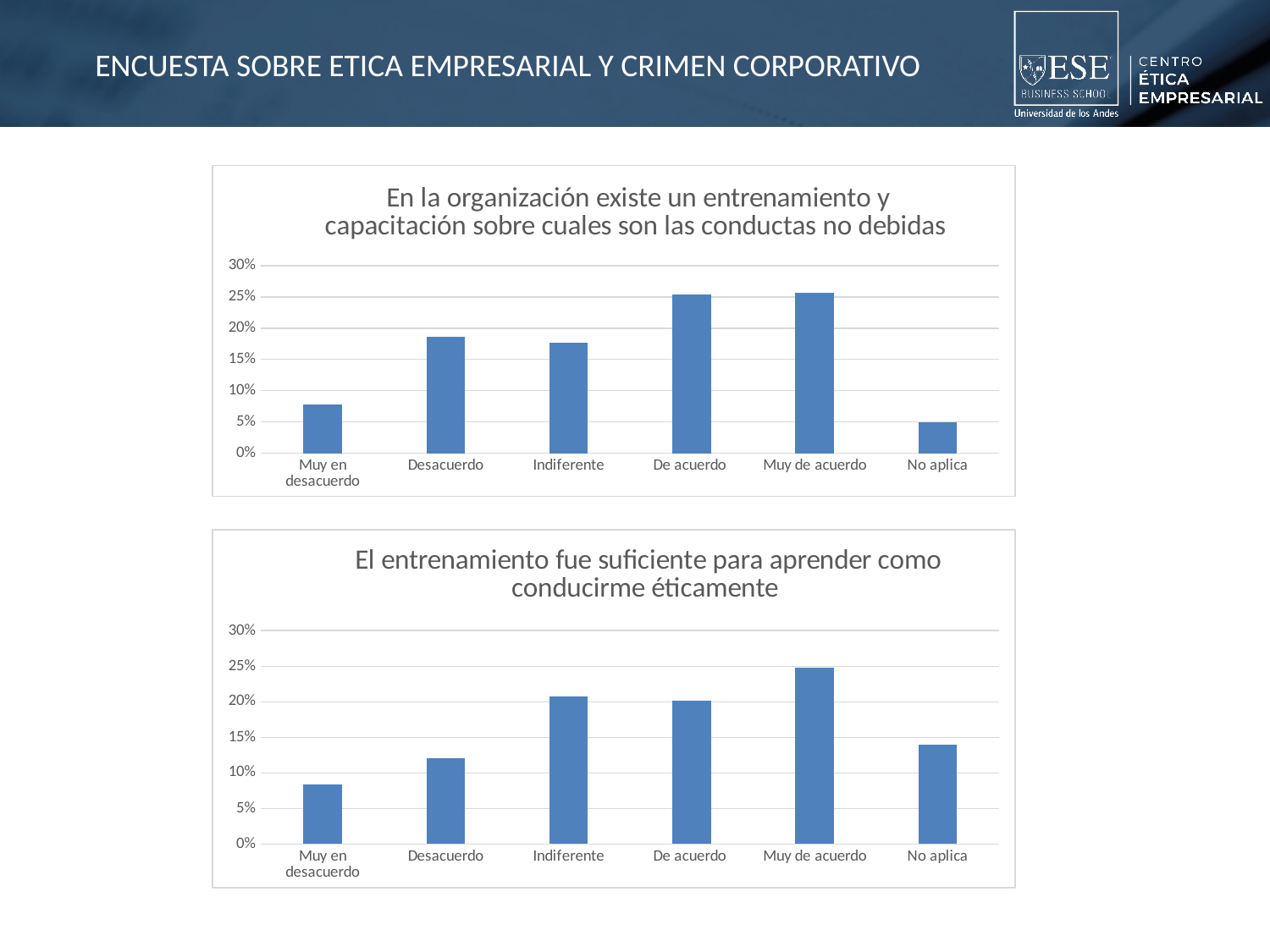
What type of chart is the top chart on the slide? Bar chart In the top chart, is the value for Desacuerdo greater or less than 15%? greater In the bottom chart, 'El entrenamiento fue suficiente para aprender como conducirme éticamente', which category has the lowest value? Muy en desacuerdo In the top chart, 'En la organización existe un entrenamiento y capacitación sobre cuales son las conductas no debidas', which category has the lowest value? No aplica In the bottom chart, 'El entrenamiento fue suficiente para aprender como conducirme éticamente', which category has the highest value? Muy de acuerdo In the top chart, is the value for Muy en desacuerdo greater or less than 10%? less In the bottom chart, is the value for Desacuerdo greater or less than 10%? greater How many categories are shown on the x axis of the bottom chart, 'El entrenamiento fue suficiente para aprender como conducirme éticamente'? 6 In the bottom chart, which is larger, the value for Indiferente or the value for Desacuerdo? Indiferente In the top chart, which is larger, the value for Desacuerdo or the value for No aplica? Desacuerdo